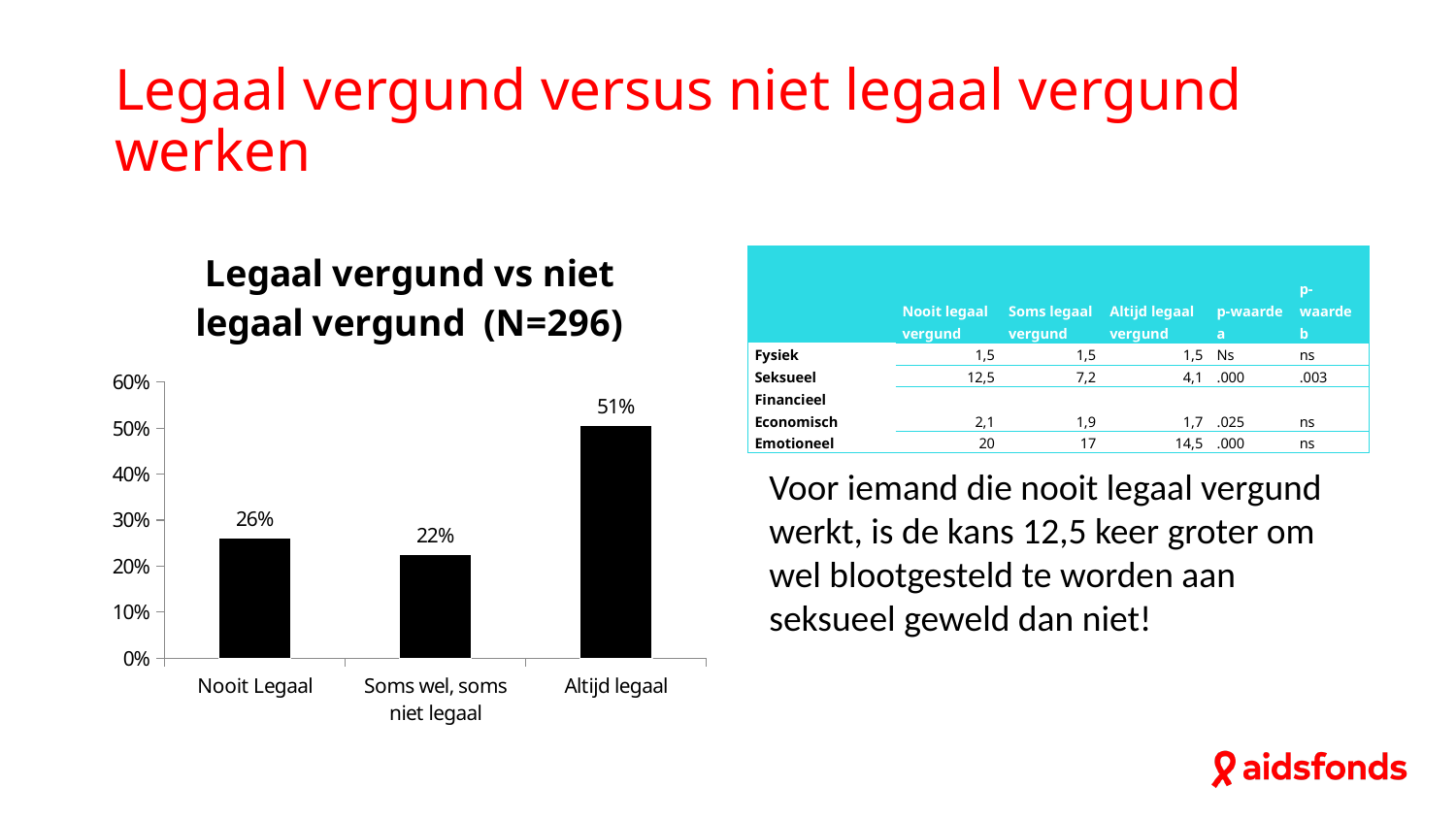
What is the value for Nooit Legaal in the chart? 26% What is the title of the chart? Legaal vergund vs niet legaal vergund (N=296) What is the value for Soms wel, soms niet legaal in the chart? 22% How many categories are shown in the chart? 3 Which category has the lowest value in the chart? Soms wel, soms niet legaal What is the difference between the values for Nooit Legaal and Soms wel, soms niet legaal? 4% Which is larger, the value for Nooit Legaal or the value for Soms wel, soms niet legaal? Nooit Legaal What kind of chart is shown on the slide? bar chart What is the difference between the values for Altijd legaal and Nooit Legaal? 25% Which category has the highest value in the chart? Altijd legaal What is the value for Altijd legaal in the chart? 51% Is the value for Altijd legaal greater or less than 40%? greater